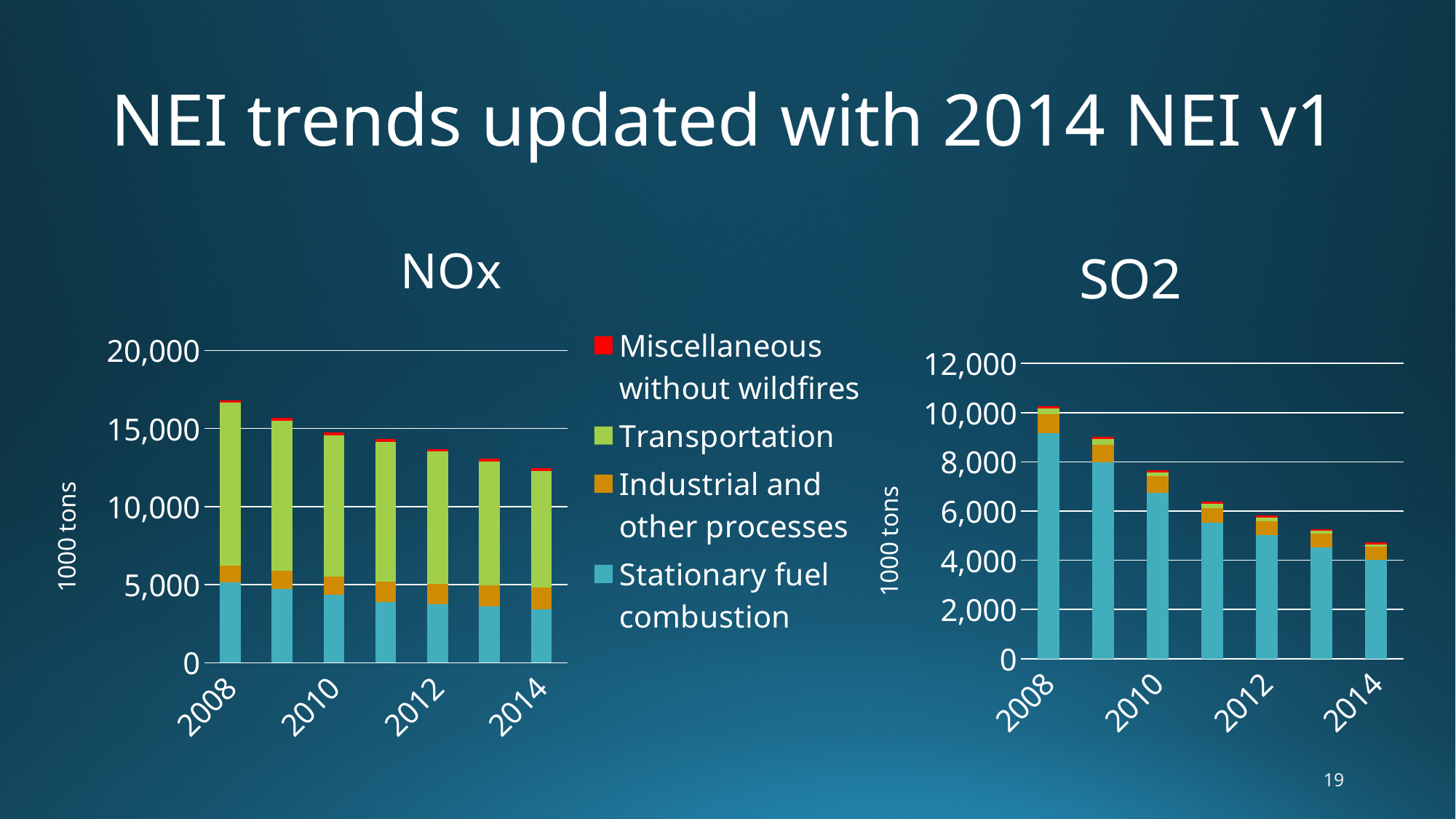
What kind of chart is the NOx chart? stacked bar chart How many bars (years) are plotted in the SO2 chart? 7 In the NOx chart, which year has the highest total bar? 2008 In the NOx chart, do the total emissions rise or fall from 2008 to 2014? fall In the NOx chart, is the total value for 2014 greater or less than 15,000? less How many series does the legend list? 4 In the NOx chart, is the total value for 2008 greater or less than 15,000? greater What is the y-axis label on the SO2 chart? 1000 tons In the SO2 chart, is the total value for 2014 greater or less than 6,000? less In the SO2 chart, which year has the lowest total bar? 2014 In the SO2 chart, do the total emissions rise or fall from 2008 to 2014? fall